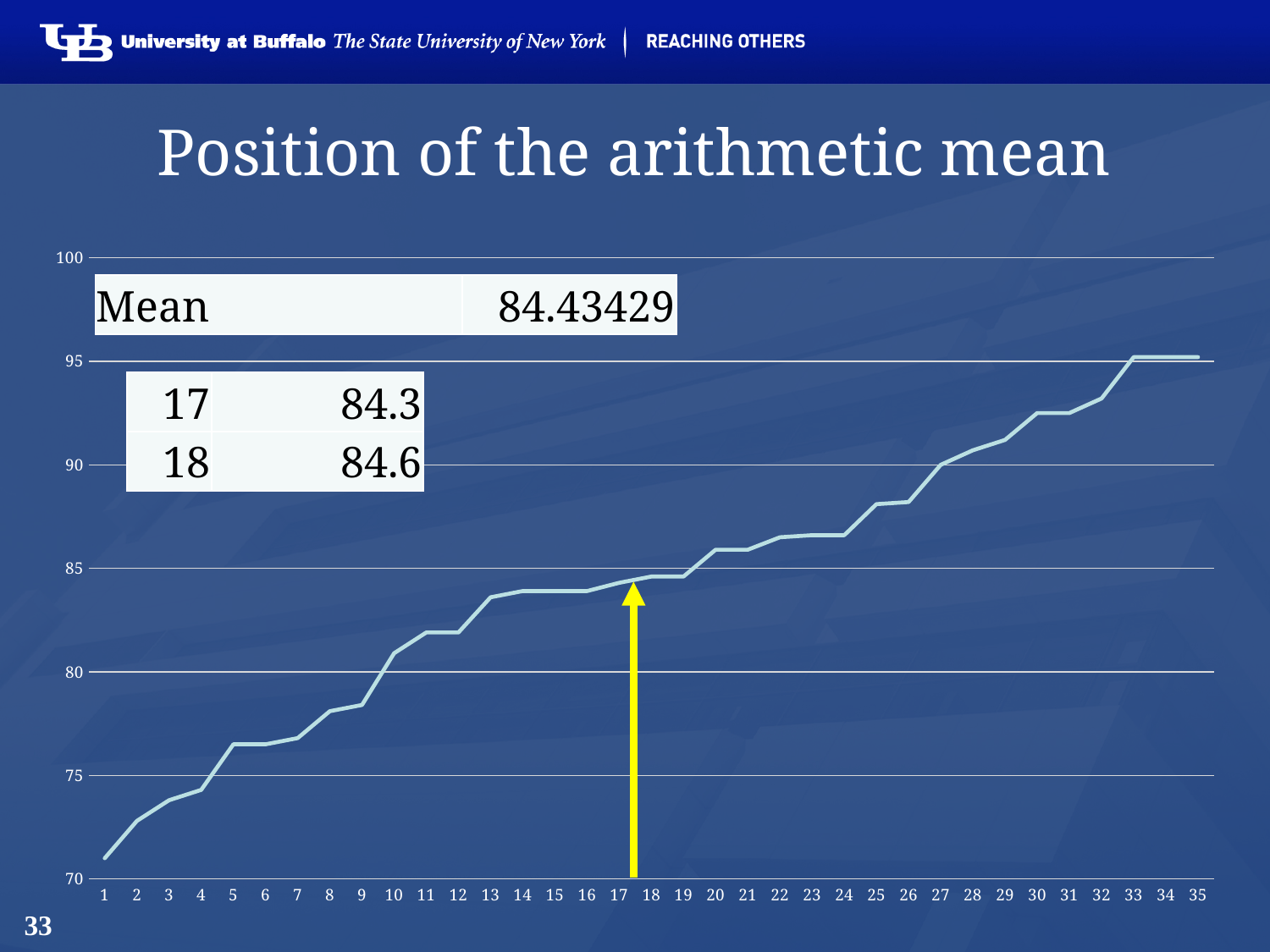
What is the title of the chart on the slide? Position of the arithmetic mean Which position has the lowest value on the chart? 1 What is the difference between the values for positions 18 and 17? 0.3 Is the value for position 1 greater or less than 75? less Is the value for position 25 greater or less than 85? greater Do the plotted values rise or fall as the x axis goes from 1 to 35? rise What is the mean value shown in the table on the slide? 84.43429 Which has the larger value, position 17 or position 18? 18 What is the value for position 18 according to the table on the slide? 84.6 What is the value for position 17 according to the table on the slide? 84.3 How many data points are plotted along the x axis? 35 What kind of chart is shown on the slide? line chart